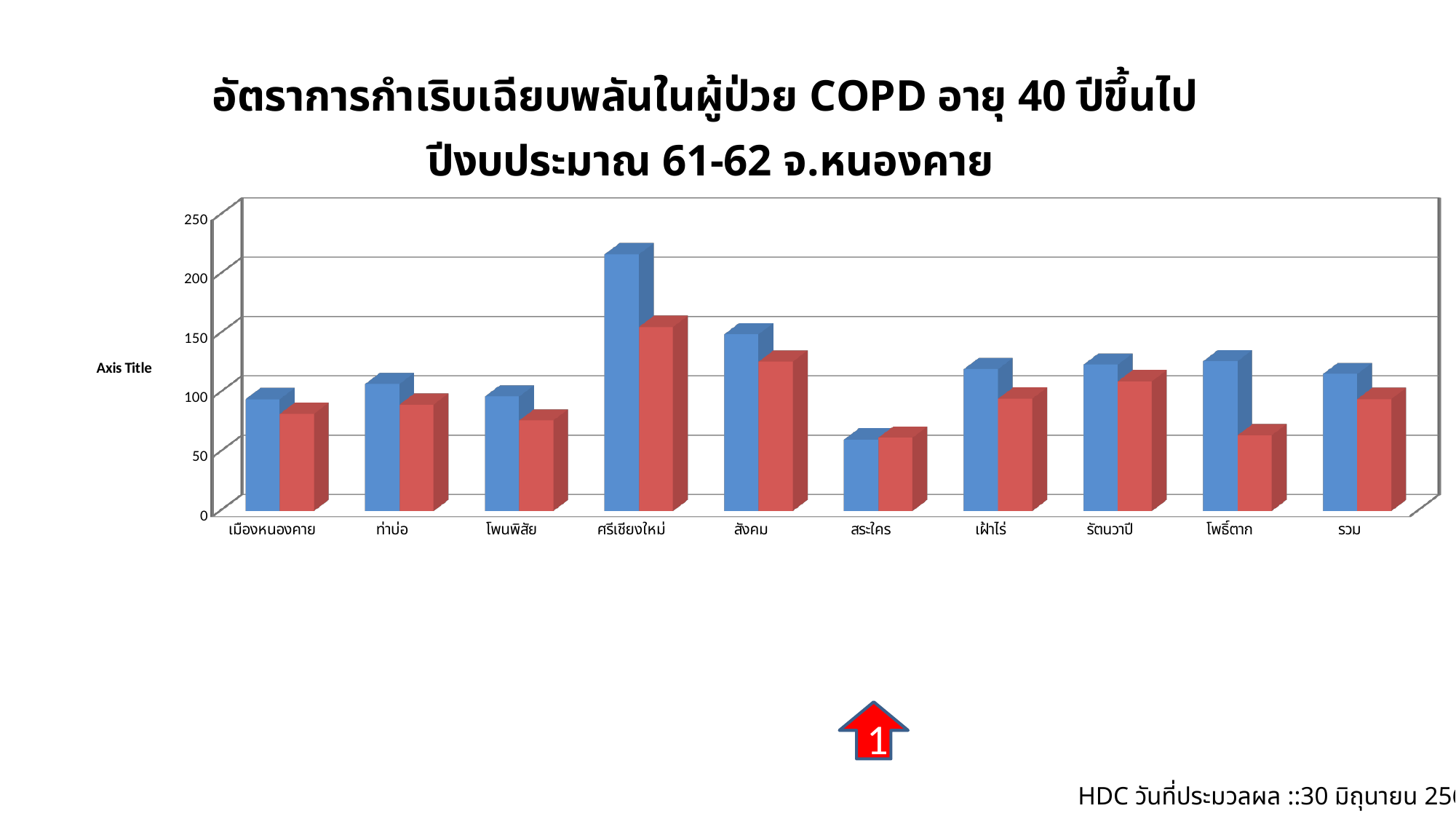
Which category has the shortest blue bar? สระใคร For โพธิ์ตาก, which bar is taller, the blue one or the red one? blue What kind of chart is shown on the slide? bar chart Is the red bar for โพธิ์ตาก greater or less than 100? less How many categories are shown along the x axis of the chart? 10 Which category has the tallest blue bar? ศรีเชียงใหม่ Is the blue bar for ศรีเชียงใหม่ greater or less than 200? greater Is the blue bar for สระใคร greater or less than 100? less How many bars are plotted for each category in the chart? 2 For ศรีเชียงใหม่, which bar is taller, the blue one or the red one? blue Which category has the tallest red bar? ศรีเชียงใหม่ What is the label shown on the vertical axis of the chart? Axis Title